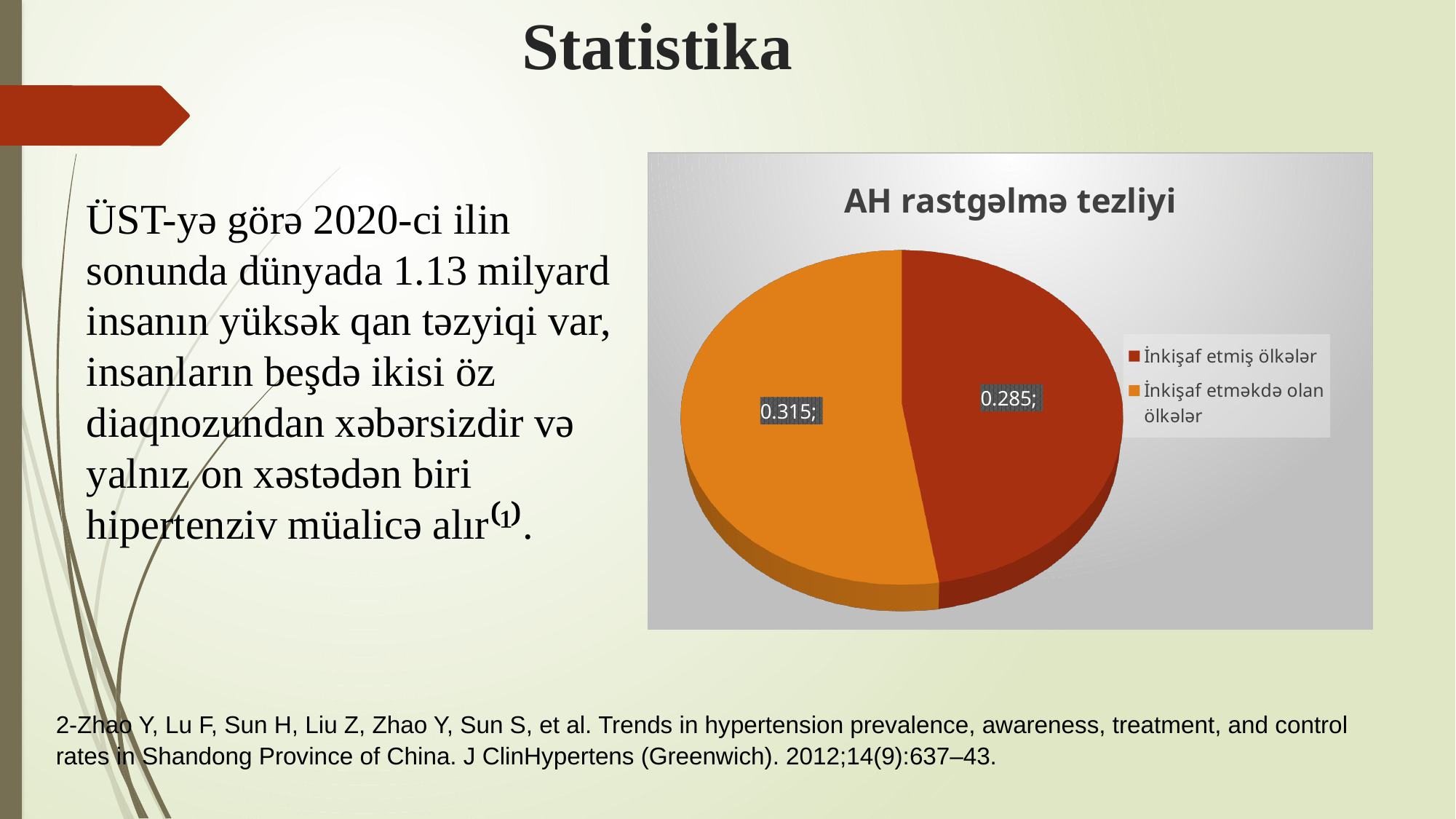
What is the title of the chart? AH rastgəlmə tezliyi What colour is the slice for İnkişaf etmiş ölkələr? red What share of the pie does the İnkişaf etməkdə olan ölkələr slice represent? 52.5% Which category has the smallest slice of the pie? İnkişaf etmiş ölkələr Which is larger, the value for İnkişaf etmiş ölkələr or for İnkişaf etməkdə olan ölkələr? İnkişaf etməkdə olan ölkələr What is the value for İnkişaf etməkdə olan ölkələr? 0.315 What is the difference between the values for İnkişaf etməkdə olan ölkələr and İnkişaf etmiş ölkələr? 0.03 What is the value for İnkişaf etmiş ölkələr? 0.285 Which category has the largest slice of the pie? İnkişaf etməkdə olan ölkələr How many entries does the legend list? 2 How many slices does the pie chart have? 2 What type of chart is shown on the slide? pie chart